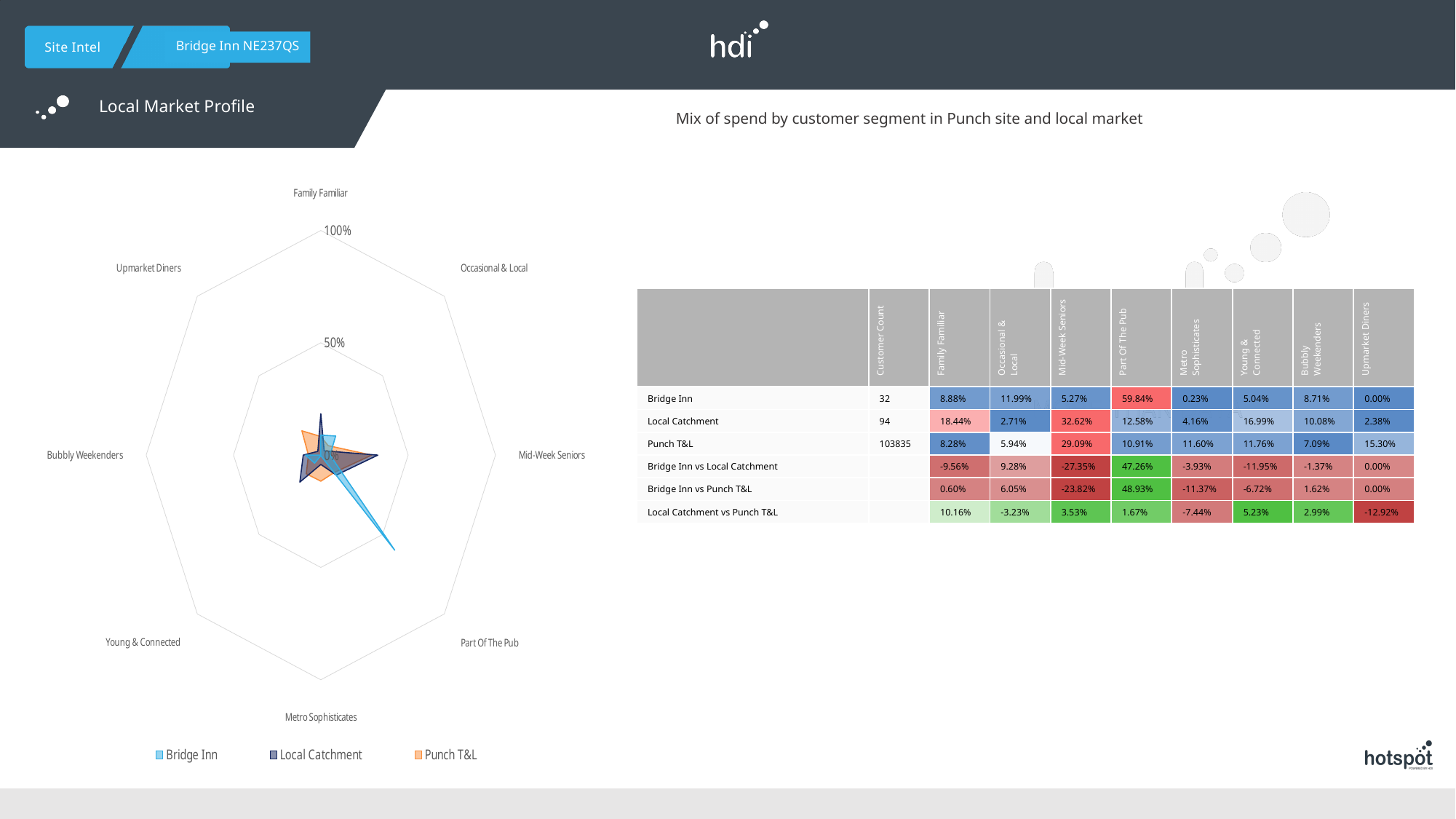
What is the Bridge Inn value for Part Of The Pub? 59.84% Is the Bridge Inn value for Part Of The Pub greater or less than 50%? greater What colour represents Bridge Inn in the radar chart legend? Light blue Which customer segment has the lowest value for Bridge Inn? Upmarket Diners How many customer segments are plotted around the radar chart? 8 Which customer segment has the highest value for Bridge Inn? Part Of The Pub How many series does the legend of the radar chart list? 3 Is the Local Catchment value for Mid-Week Seniors greater or less than 50%? less What kind of chart is shown on the left of the slide? Radar chart Which customer segment has the highest value for Local Catchment? Mid-Week Seniors For Mid-Week Seniors, which is larger: Bridge Inn or Local Catchment? Local Catchment What is the difference between the Bridge Inn and Local Catchment values for Part Of The Pub? 47.26%